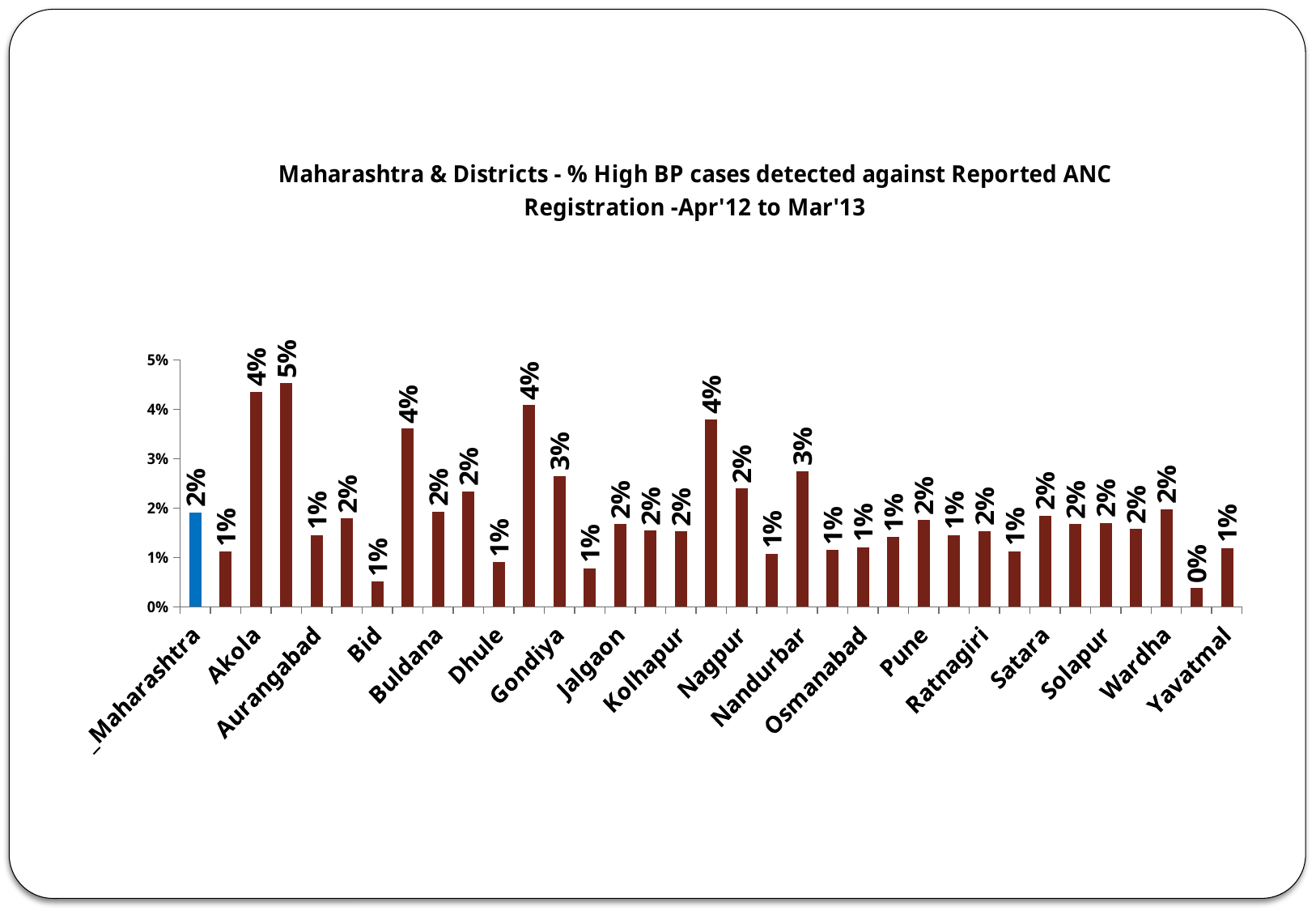
What colour is the bar for _Maharashtra? blue What is the title of the chart? Maharashtra & Districts - % High BP cases detected against Reported ANC Registration -Apr'12 to Mar'13 What is the highest data label value shown on the chart? 5% Which has a larger value, Akola or Aurangabad? Akola What is the value shown for _Maharashtra? 2% What is the value shown for Yavatmal? 1% What is the lowest data label value shown on the chart? 0% What is the difference between the values for Akola and _Maharashtra? 2% What kind of chart is shown on the slide? bar chart What is the value shown for Gondiya? 3% What is the value shown for Nandurbar? 3% What is the value shown for Akola? 4%